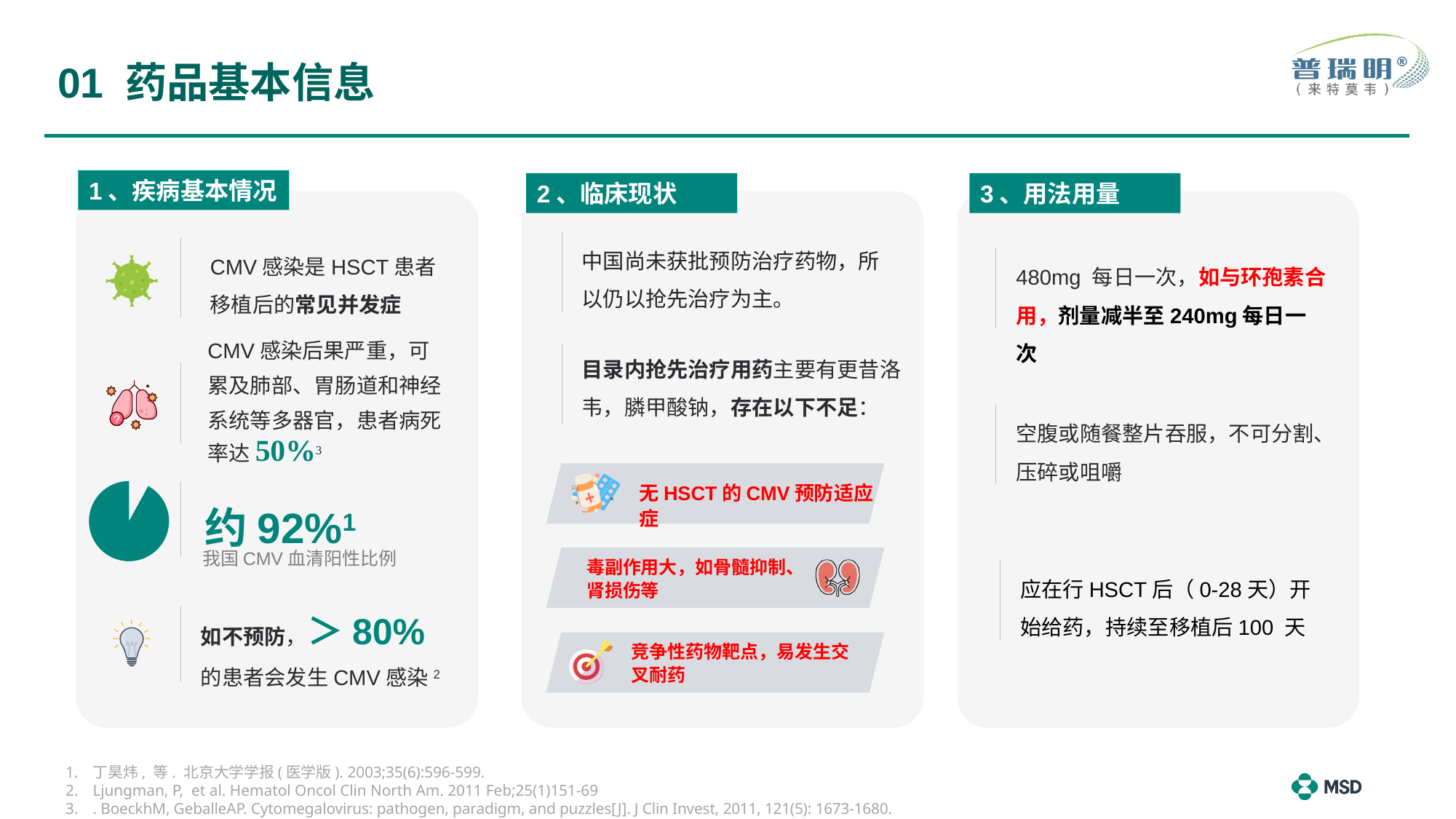
What kind of chart is shown in the left panel next to the text 约 92%? pie chart What value is printed next to the pie chart in the left panel? 约 92% Is the share shown by the filled slice of the pie chart greater or less than 50%? greater How many slices does the pie chart in the left panel show? 2 What does the pie chart in the left panel represent, according to its caption? 我国 CMV 血清阳性比例